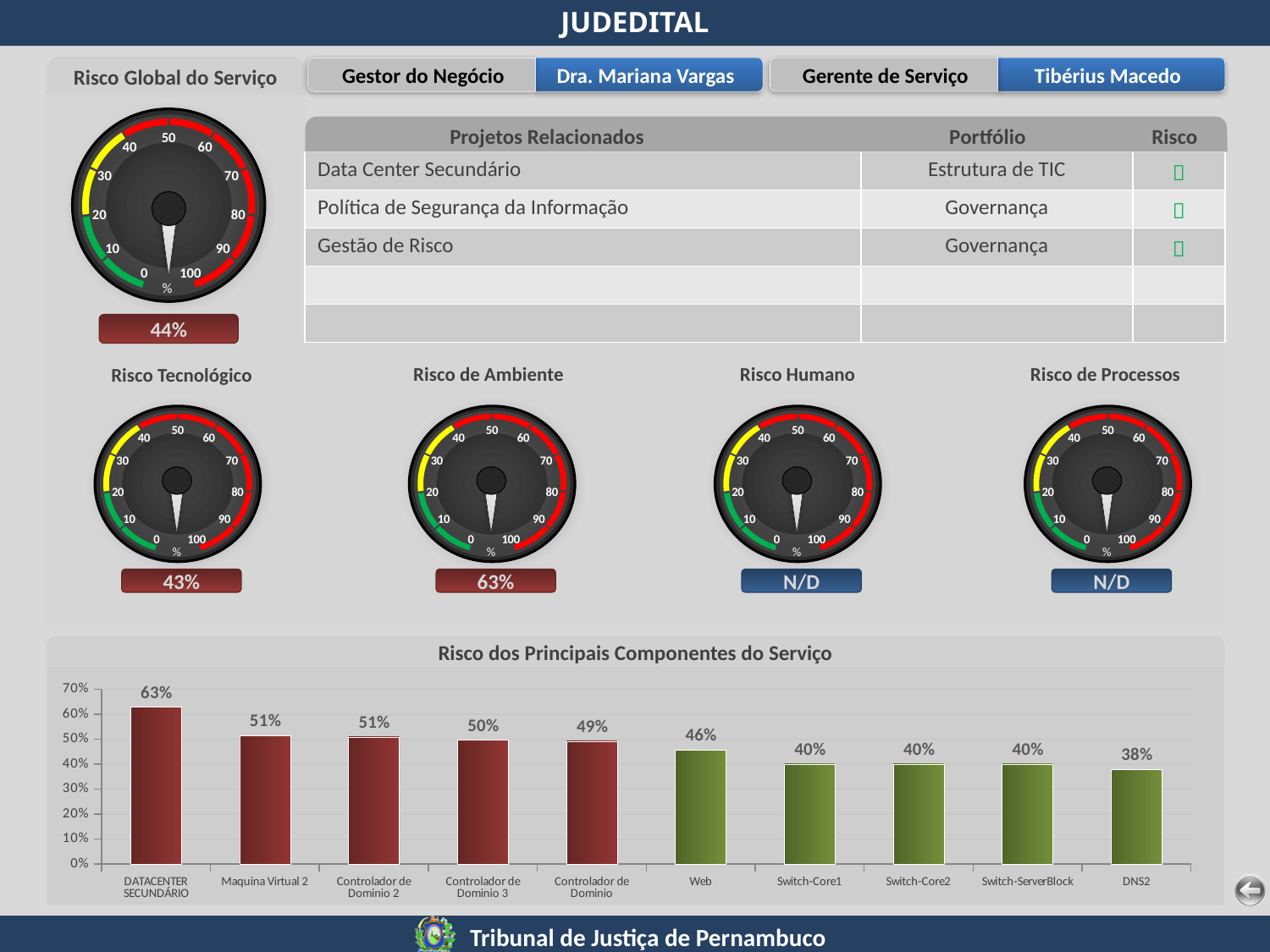
In the 'Risco dos Principais Componentes do Serviço' bar chart, do the values rise or fall from left to right? Fall In the 'Risco dos Principais Componentes do Serviço' bar chart, which component has the highest value? DATACENTER SECUNDÁRIO In the 'Risco dos Principais Componentes do Serviço' bar chart, what is the value for DATACENTER SECUNDÁRIO? 63% What value is shown below the 'Risco Global do Serviço' gauge? 44% In the 'Risco dos Principais Componentes do Serviço' bar chart, what is the value for DNS2? 38% What kind of chart is 'Risco dos Principais Componentes do Serviço'? Bar chart What value is shown below the 'Risco de Ambiente' gauge? 63% In the 'Risco dos Principais Componentes do Serviço' bar chart, which is larger: Controlador de Dominio 3 or Switch-Core1? Controlador de Dominio 3 In the 'Risco dos Principais Componentes do Serviço' bar chart, which component has the lowest value? DNS2 In the 'Risco dos Principais Componentes do Serviço' bar chart, what is the value for Web? 46% In the 'Risco dos Principais Componentes do Serviço' bar chart, how many components are plotted? 10 In the 'Risco dos Principais Componentes do Serviço' bar chart, what is the difference between DATACENTER SECUNDÁRIO and Web? 17%